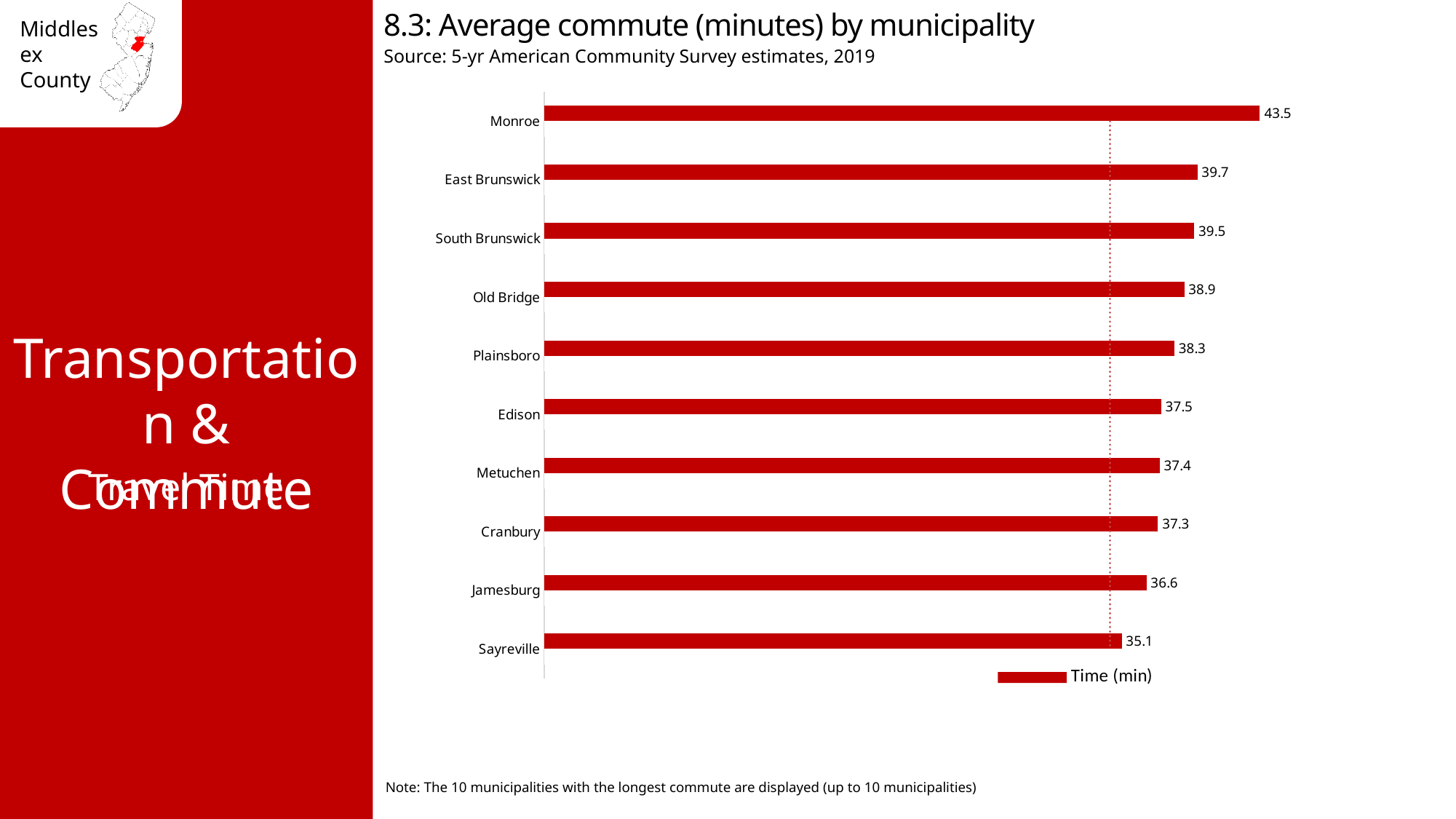
Which has a longer average commute, South Brunswick or Edison? South Brunswick What kind of chart is shown on the slide? Bar chart What is the difference in average commute time between East Brunswick and Old Bridge? 0.8 What is the average commute time for Monroe? 43.5 Which municipality has the shortest average commute shown on the chart? Sayreville Which municipality has the longest average commute? Monroe How many municipalities are shown on the chart? 10 What is the average commute time for Plainsboro? 38.3 What is the difference in average commute time between Monroe and Sayreville? 8.4 How many series does the legend list? 1 What is the average commute time for Jamesburg? 36.6 What is the legend entry for the series shown on the chart? Time (min)